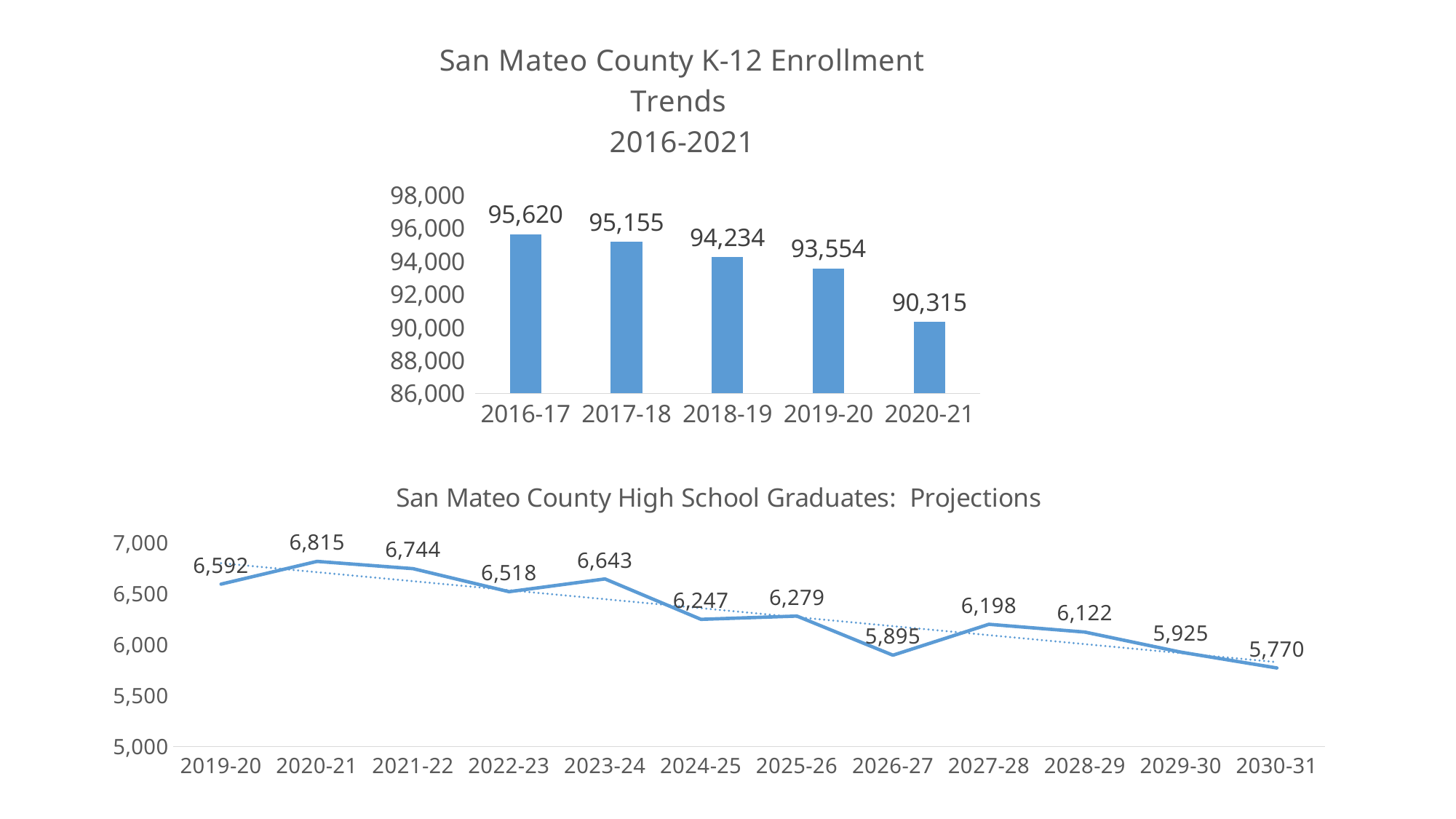
In the San Mateo County High School Graduates: Projections chart, how many years are plotted? 12 In the San Mateo County High School Graduates: Projections chart, what is the projected number of graduates for 2026-27? 5,895 In the San Mateo County K-12 Enrollment Trends chart, what is the enrollment for 2018-19? 94,234 In the San Mateo County K-12 Enrollment Trends chart, which year has the lowest enrollment? 2020-21 What kind of chart is the San Mateo County K-12 Enrollment Trends chart? bar chart In the San Mateo County High School Graduates: Projections chart, which is larger, the value for 2023-24 or the value for 2024-25? 2023-24 In the San Mateo County K-12 Enrollment Trends chart, how many years are shown? 5 In the San Mateo County High School Graduates: Projections chart, which year has the highest projected number of graduates? 2020-21 In the San Mateo County K-12 Enrollment Trends chart, do the values rise or fall from 2016-17 to 2020-21? fall What kind of chart is the San Mateo County High School Graduates: Projections chart? line chart In the San Mateo County High School Graduates: Projections chart, what is the difference between the values for 2020-21 and 2030-31? 1,045 In the San Mateo County K-12 Enrollment Trends chart, what is the difference in enrollment between 2016-17 and 2020-21? 5,305